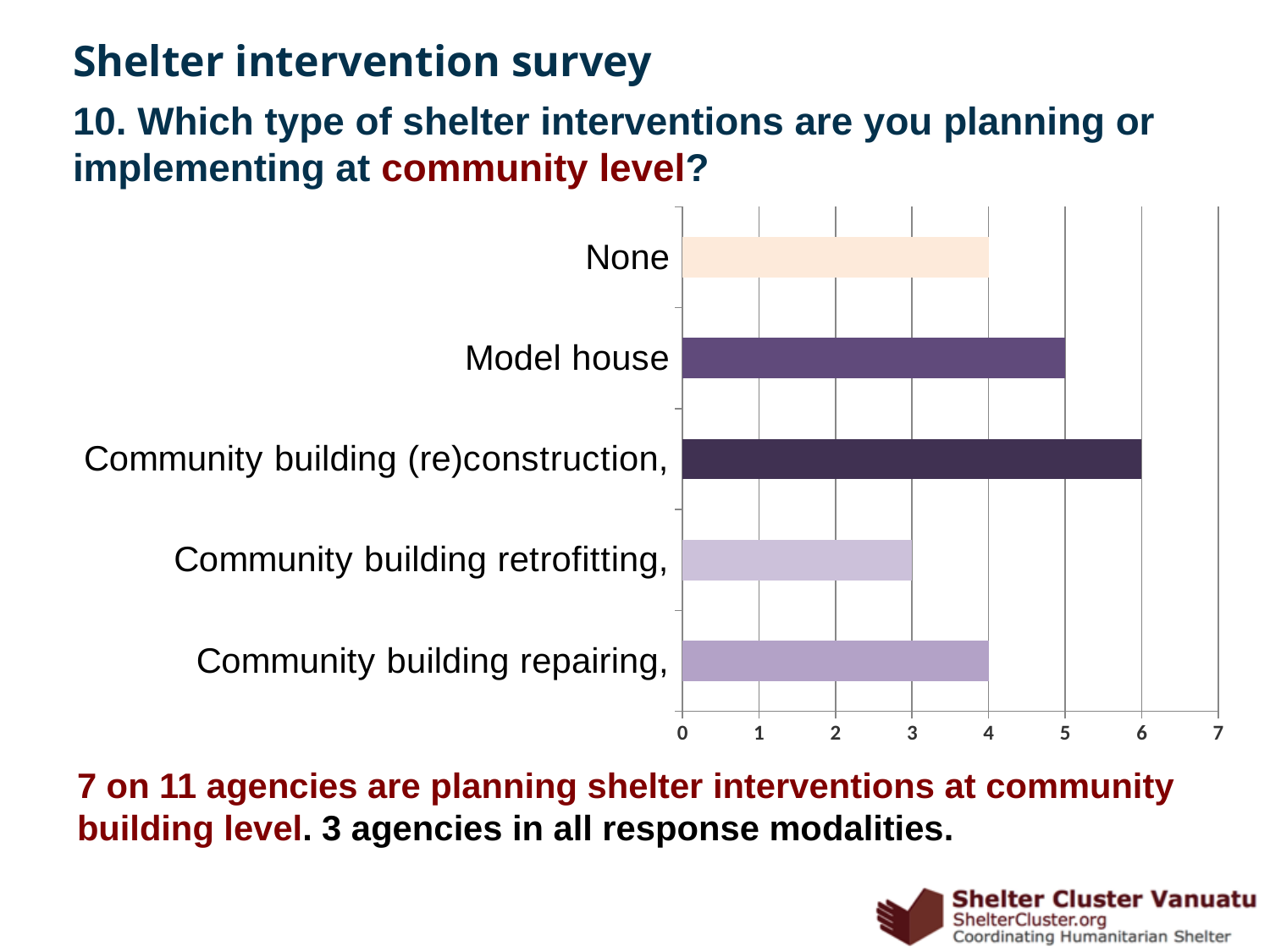
What is the maximum value shown on the horizontal axis? 7 What is the value for Community building retrofitting? 3 Which category has the highest value? Community building (re)construction Which is larger, the value for Model house or the value for Community building repairing? Model house What is the value for Model house? 5 What is the value for None? 4 What is the value for Community building (re)construction? 6 How many categories are plotted in the chart? 5 Which category has the lowest value? Community building retrofitting What kind of chart is shown on the slide? bar chart Is the value for Community building (re)construction greater or less than 5? greater What is the difference between the values for Community building (re)construction and Community building retrofitting? 3